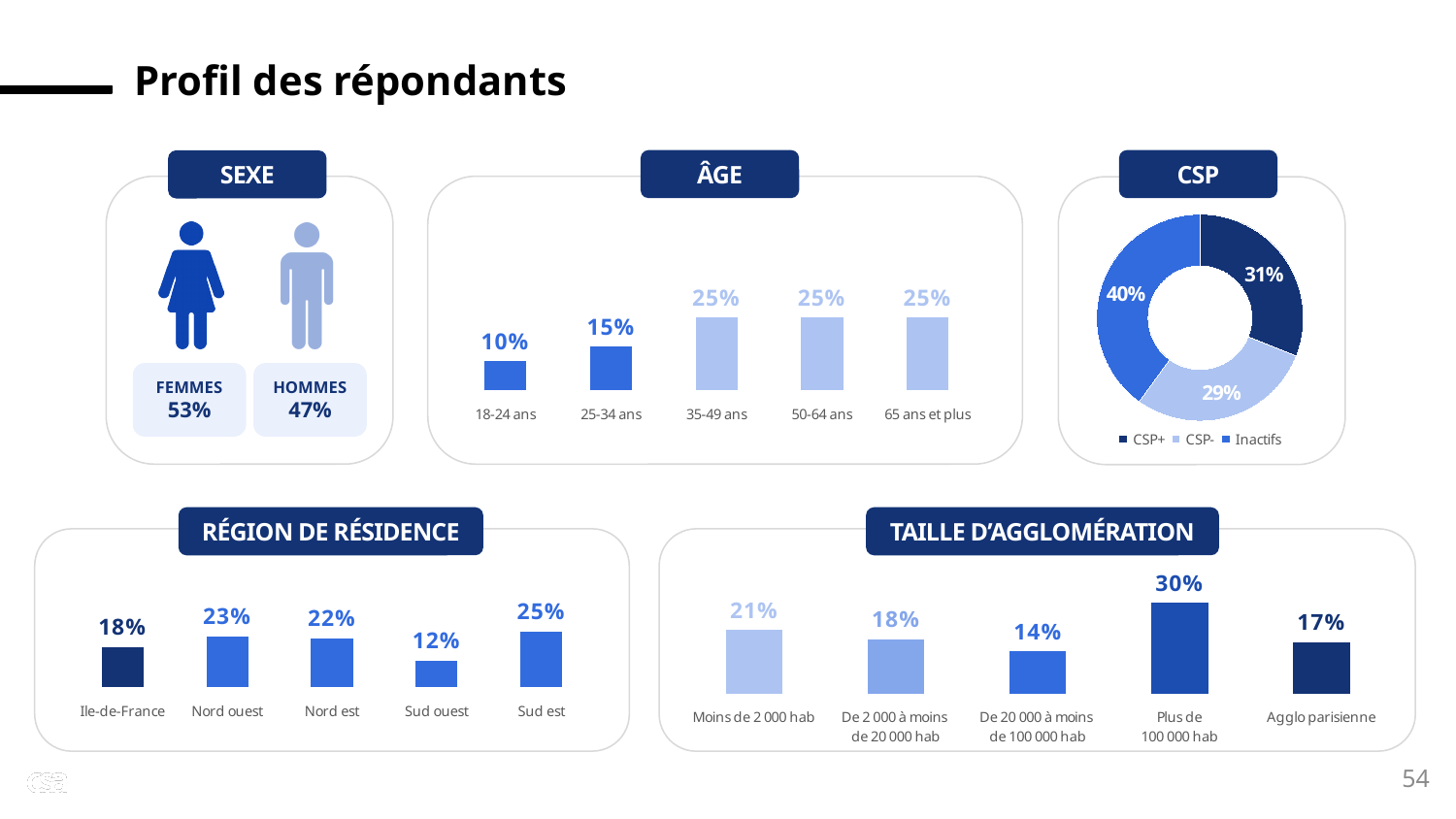
In the RÉGION DE RÉSIDENCE chart, what is the difference between Nord ouest and Ile-de-France? 5% In the TAILLE D'AGGLOMÉRATION chart, which is larger: Moins de 2 000 hab or Agglo parisienne? Moins de 2 000 hab In the ÂGE chart, what is the value for 18-24 ans? 10% In the CSP chart, what share of the pie is CSP-? 29% In the ÂGE chart, how many age categories are shown? 5 In the CSP chart, how many entries does the legend list? 3 In the RÉGION DE RÉSIDENCE chart, which region has the highest value? Sud est In the TAILLE D'AGGLOMÉRATION chart, which category has the highest value? Plus de 100 000 hab In the RÉGION DE RÉSIDENCE chart, what is the value for Sud ouest? 12% In the ÂGE chart, which age group has the lowest value? 18-24 ans In the CSP chart, which category has the largest share? Inactifs What kind of chart is the CSP chart? Doughnut chart